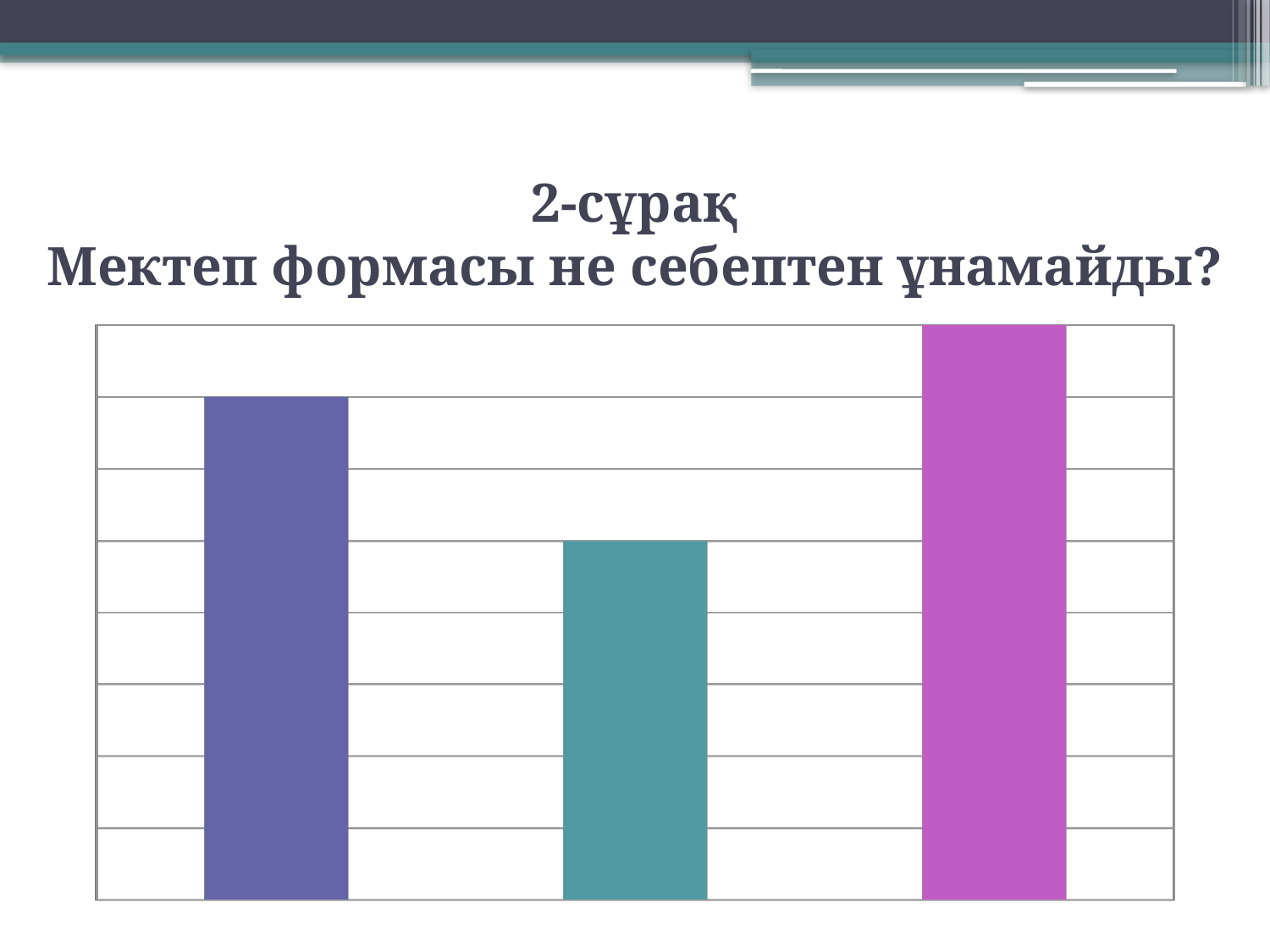
What question is written as the heading above the chart? Мектеп формасы не себептен ұнамайды? What kind of chart is shown on the slide? bar chart What colour is the middle bar in the chart? teal Which is taller, the right magenta bar or the left purple bar? the right magenta bar Which is taller, the left purple bar or the middle teal bar? the left purple bar Which bar is the shortest in the chart: the left (purple), middle (teal) or right (magenta) one? the middle (teal) bar How many bars are plotted in the chart? 3 Which bar is the tallest in the chart: the left (purple), middle (teal) or right (magenta) one? the right (magenta) bar Which is taller, the middle teal bar or the right magenta bar? the right magenta bar